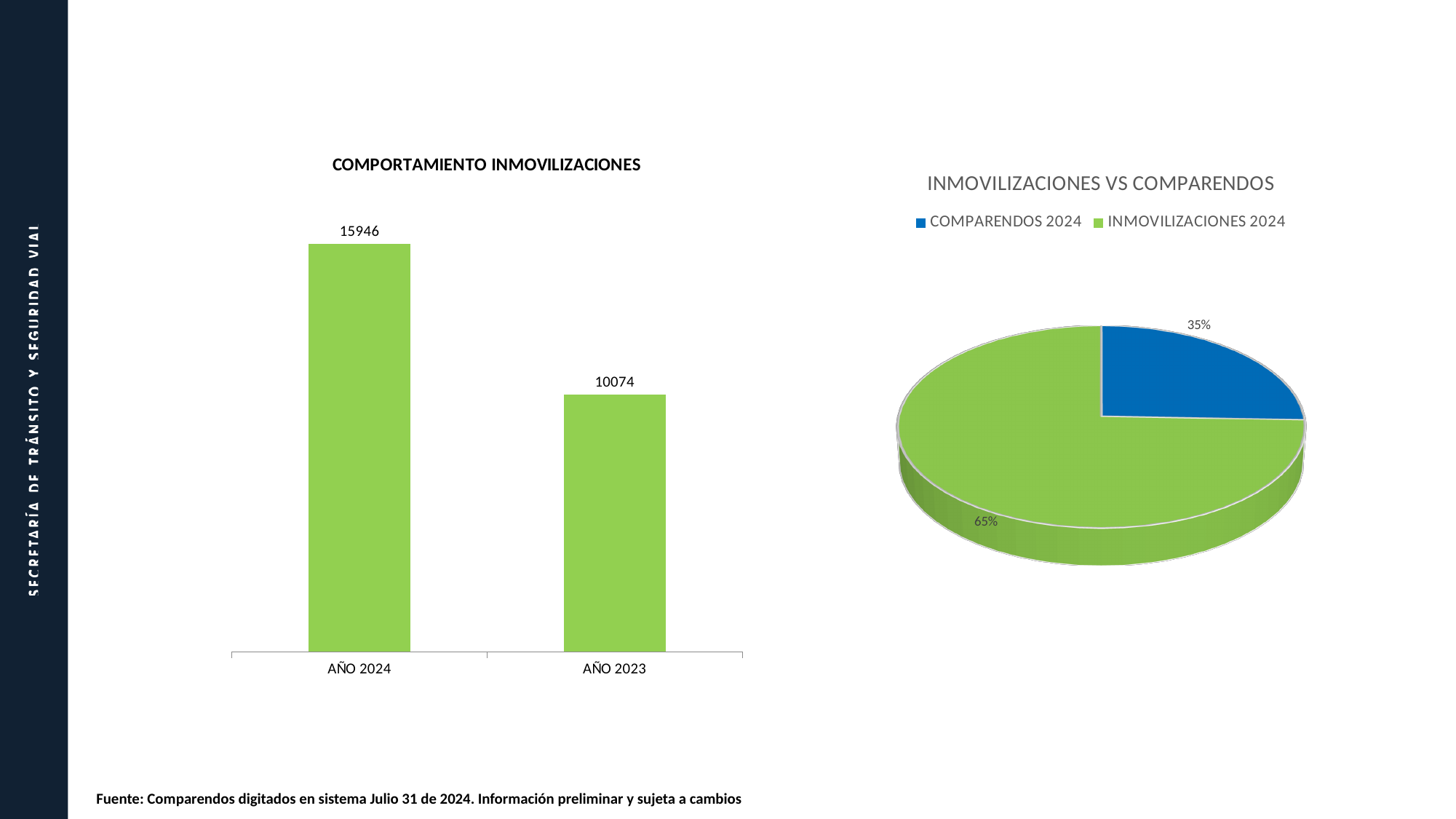
In the INMOVILIZACIONES VS COMPARENDOS chart, what share does INMOVILIZACIONES 2024 have? 65% In the INMOVILIZACIONES VS COMPARENDOS chart, how many entries does the legend list? 2 In the COMPORTAMIENTO INMOVILIZACIONES chart, what is the difference between the AÑO 2024 and AÑO 2023 values? 5872 In the COMPORTAMIENTO INMOVILIZACIONES chart, which year has the lowest value? AÑO 2023 In the COMPORTAMIENTO INMOVILIZACIONES chart, how many bars are plotted? 2 In the COMPORTAMIENTO INMOVILIZACIONES chart, what is the value for AÑO 2024? 15946 What kind of chart is COMPORTAMIENTO INMOVILIZACIONES? Bar chart In the INMOVILIZACIONES VS COMPARENDOS chart, which slice is larger, COMPARENDOS 2024 or INMOVILIZACIONES 2024? INMOVILIZACIONES 2024 What kind of chart is INMOVILIZACIONES VS COMPARENDOS? Pie chart In the COMPORTAMIENTO INMOVILIZACIONES chart, which year has the highest value? AÑO 2024 In the INMOVILIZACIONES VS COMPARENDOS chart, what share does COMPARENDOS 2024 have? 35% In the COMPORTAMIENTO INMOVILIZACIONES chart, what is the value for AÑO 2023? 10074